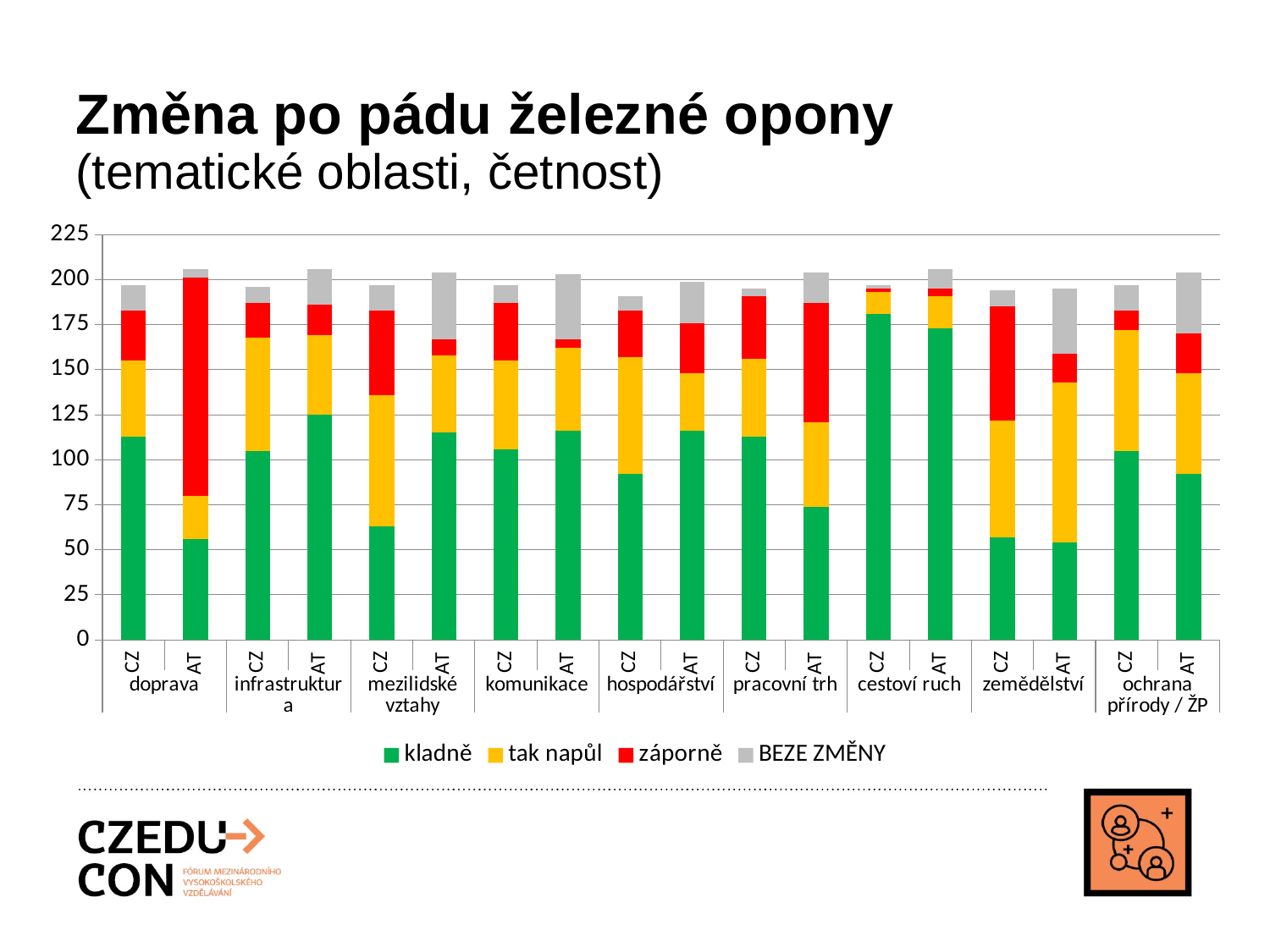
How many thematic areas (category groups) are shown on the x axis? 9 For mezilidské vztahy, which has the larger green (kladně) segment, CZ or AT? AT What kind of chart is shown on the slide? stacked bar chart For doprava, which has the larger green (kladně) segment, CZ or AT? CZ Which bar has the largest red (záporně) segment? doprava AT Which legend entry is shown in grey? BEZE ZMĚNY Which thematic area has the tallest green (kladně) segments? cestoví ruch Is the green (kladně) value for cestoví ruch CZ greater or less than 150? greater Is the green (kladně) value for doprava AT greater or less than 75? less Is the green (kladně) value for doprava CZ greater or less than 100? greater How many bars are plotted in the chart? 18 How many series does the legend list? 4